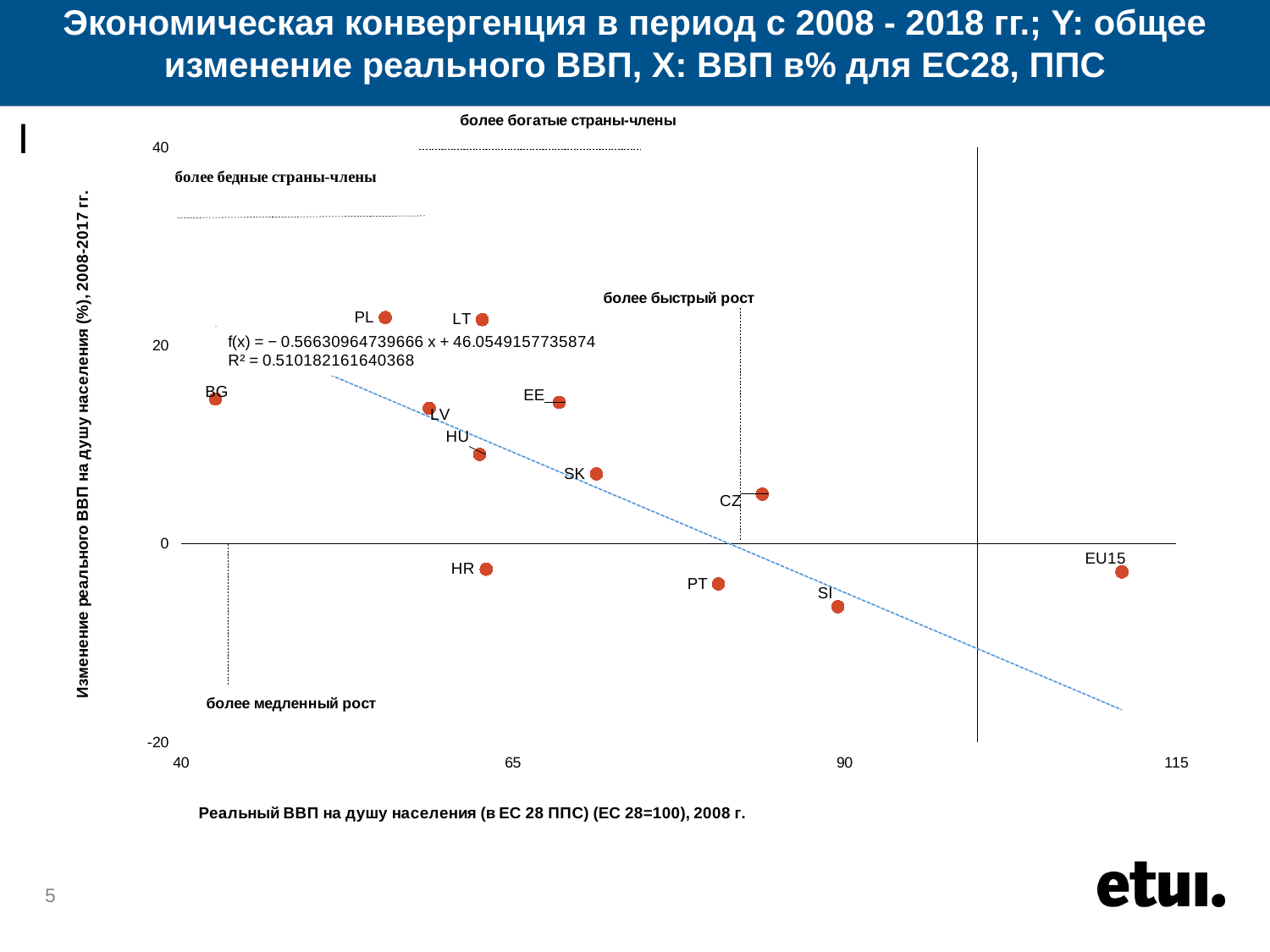
What R² value is printed on the chart for the trend line? R² = 0.510182161640368 Is the x value (real GDP per capita, 2008) for EU15 greater or less than 90? greater What kind of chart is shown on the slide? scatter chart Which labelled point has the lowest value on the x axis (real GDP per capita, 2008)? BG Is the x value (real GDP per capita, 2008) for BG greater or less than 65? less Is the y value (change in real GDP per capita) for HR greater or less than 0? less Does the fitted trend line rise or fall as the x value increases? falls How many labelled data points are plotted on the chart? 12 Which labelled point has the lowest value on the y axis (change in real GDP per capita)? SI Which labelled point has the highest value on the x axis (real GDP per capita, 2008)? EU15 What is the equation of the trend line printed on the chart? f(x) = − 0.56630964739666 x + 46.0549157735874